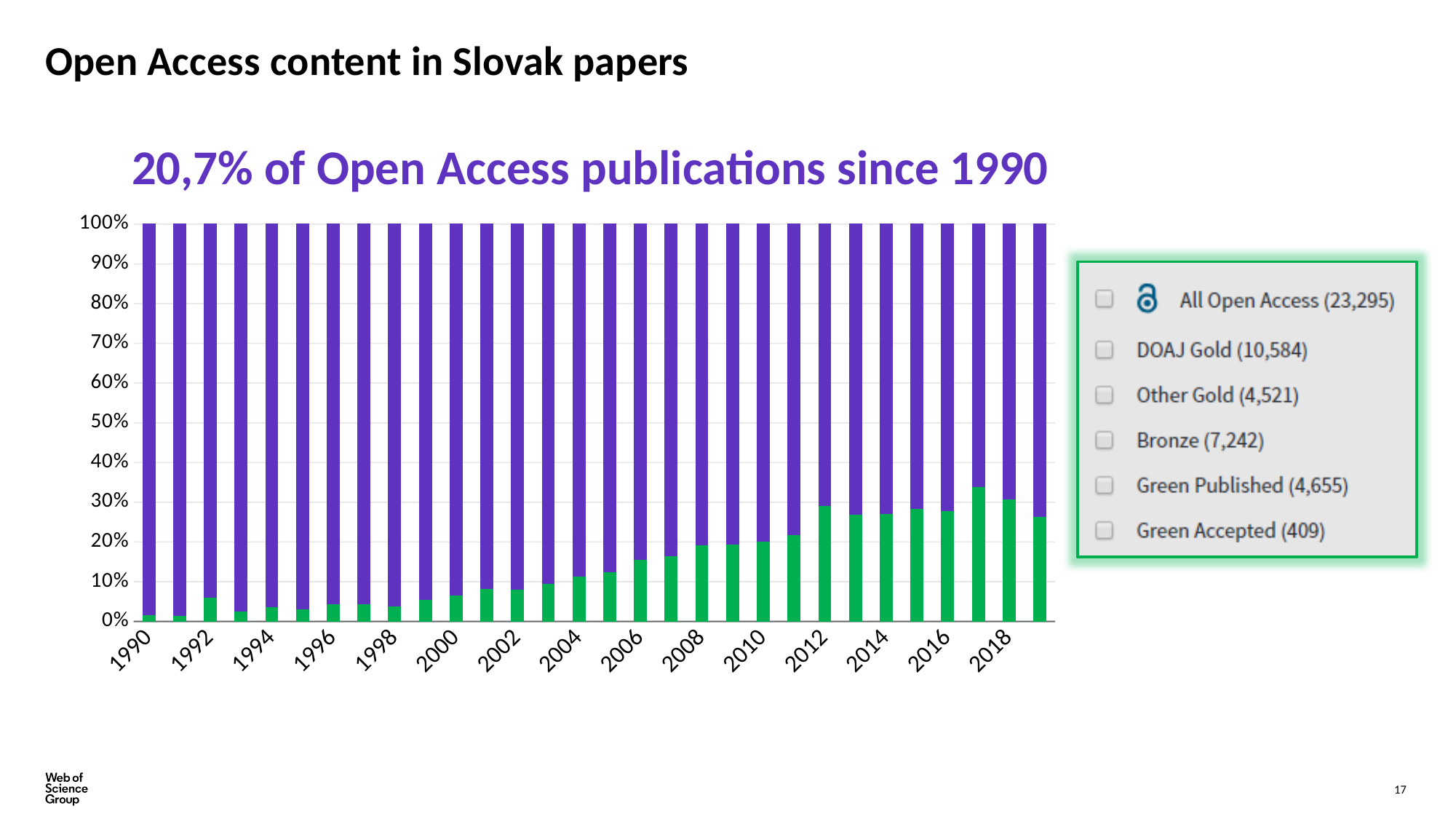
Which year has the largest green (Open Access) share in the chart? 2017 Is the green (Open Access) share for 2006 greater or less than 10%? greater Is the green (Open Access) share for 2000 greater or less than 10%? less Which year has the larger green (Open Access) share, 2017 or 2019? 2017 Is the green (Open Access) share for 2017 greater or less than 30%? greater What kind of chart is shown on the slide? Stacked bar chart Which year has the larger green (Open Access) share, 2004 or 2012? 2012 Does the green (Open Access) share generally rise or fall from 1990 to 2018? Rise What is the title shown above the chart? 20,7% of Open Access publications since 1990 How many yearly bars are plotted in the chart? 30